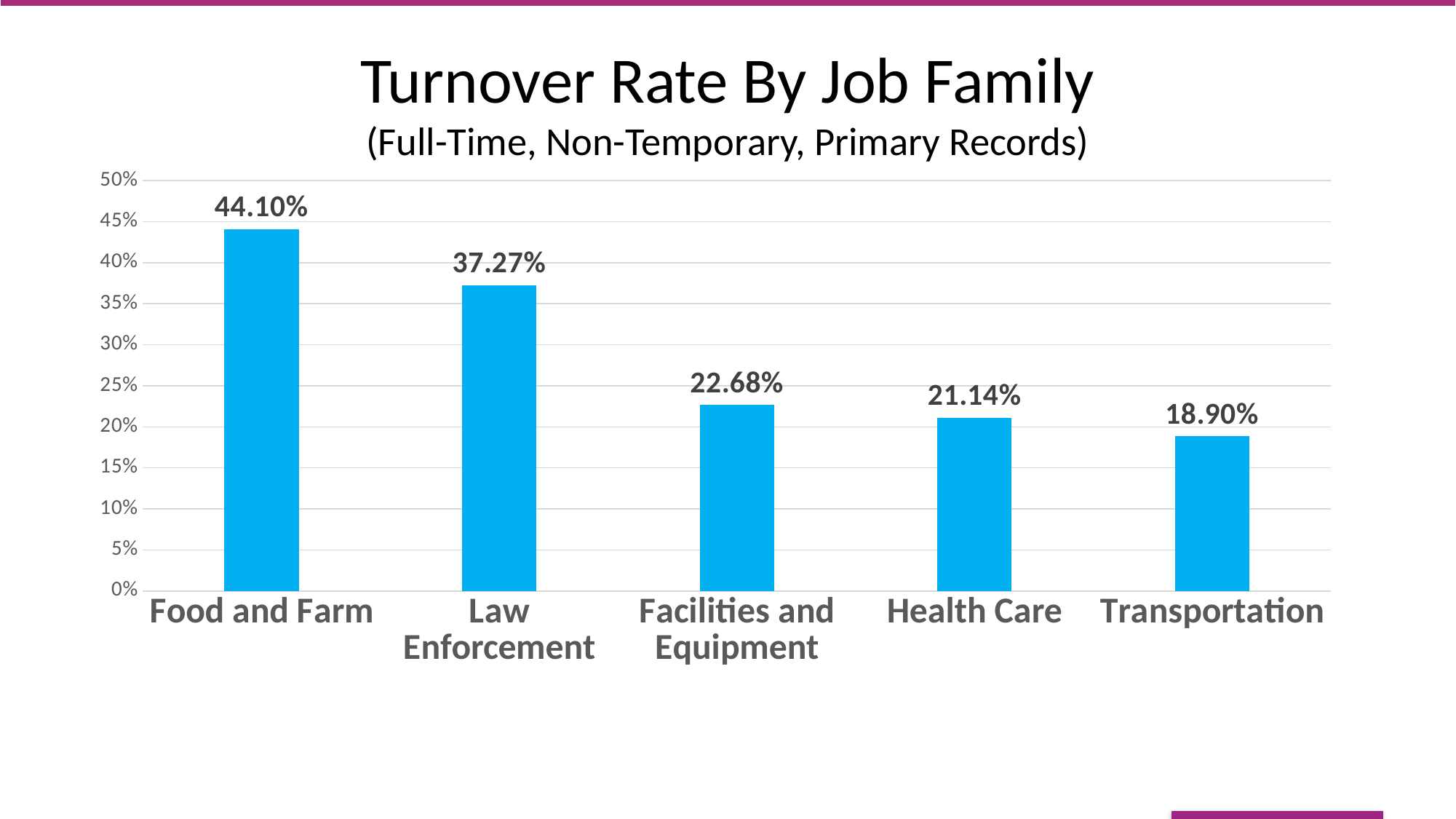
What is the difference between the turnover rates of Food and Farm and Law Enforcement? 6.83% What is the turnover rate for Food and Farm? 44.10% What is the turnover rate for Facilities and Equipment? 22.68% What is the turnover rate for Transportation? 18.90% What is the title of the chart? Turnover Rate By Job Family How many job families are shown in the chart? 5 Which job family has the lowest turnover rate? Transportation Which job family has the highest turnover rate? Food and Farm What kind of chart is shown on the slide? Bar chart Which has a higher turnover rate, Facilities and Equipment or Health Care? Facilities and Equipment What is the turnover rate for Law Enforcement? 37.27% What is the difference between the turnover rates of Health Care and Transportation? 2.24%